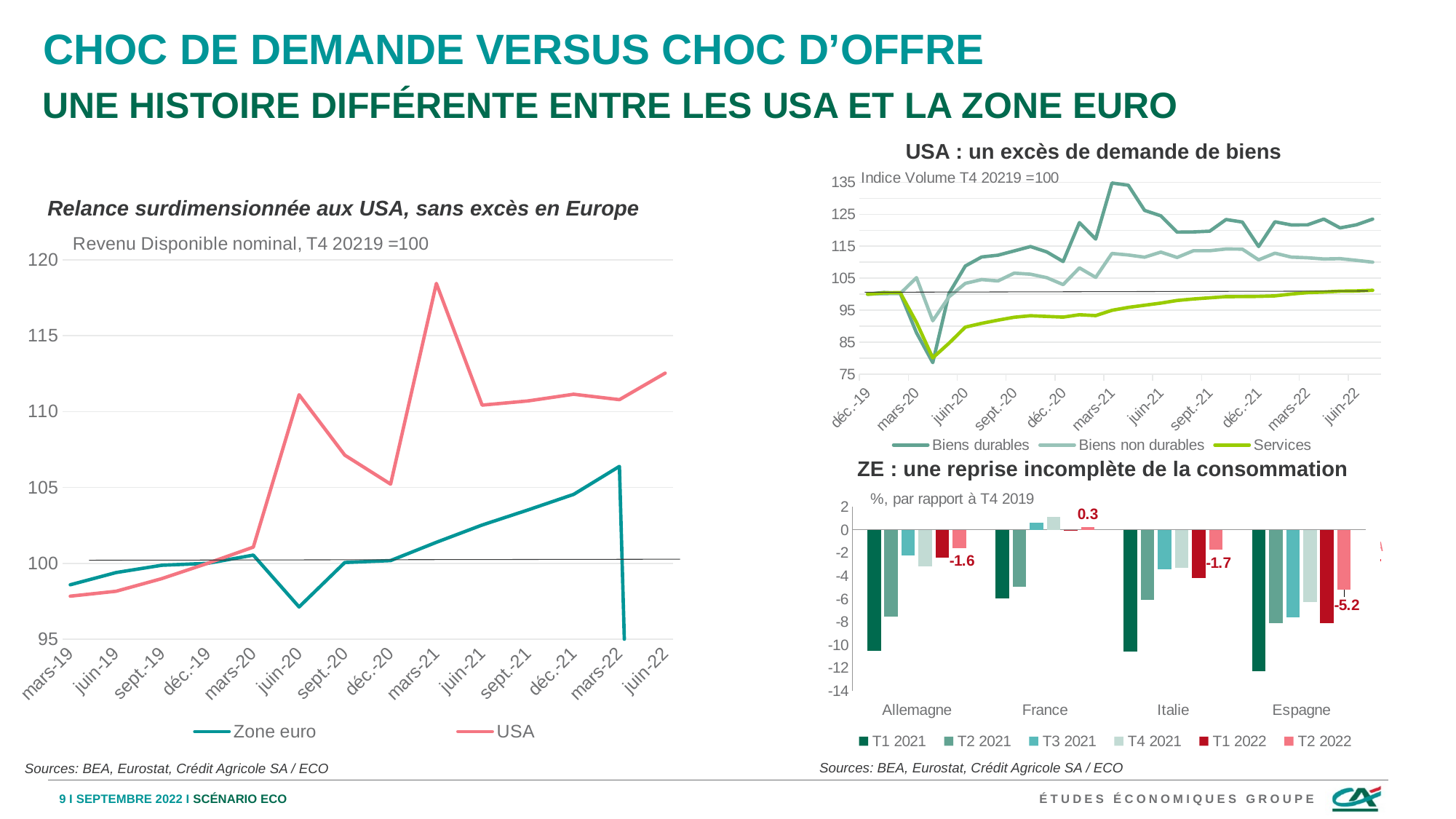
What kind of chart is the left chart titled 'Relance surdimensionnée aux USA, sans excès en Europe'? Line chart In the bottom-right chart 'ZE : une reprise incomplète de la consommation', how many countries are shown on the x axis? 4 In the top-right chart 'USA : un excès de demande de biens', how many series does the legend list? 3 In the bottom-right chart 'ZE : une reprise incomplète de la consommation', which country has the lowest T1 2021 value? Espagne In the left chart 'Relance surdimensionnée aux USA, sans excès en Europe', is the USA value at mars-21 greater or less than 115? greater In the bottom-right chart 'ZE : une reprise incomplète de la consommation', what is the labelled value for France in T2 2022? 0.3 In the left chart 'Relance surdimensionnée aux USA, sans excès en Europe', how many series does the legend list? 2 In the top-right chart 'USA : un excès de demande de biens', is the Biens durables value at mars-21 greater or less than 125? greater In the bottom-right chart 'ZE : une reprise incomplète de la consommation', what is the labelled value for Espagne in T2 2022? -5.2 In the top-right chart 'USA : un excès de demande de biens', does the Services series rise or fall from juin-20 to juin-22? Rise